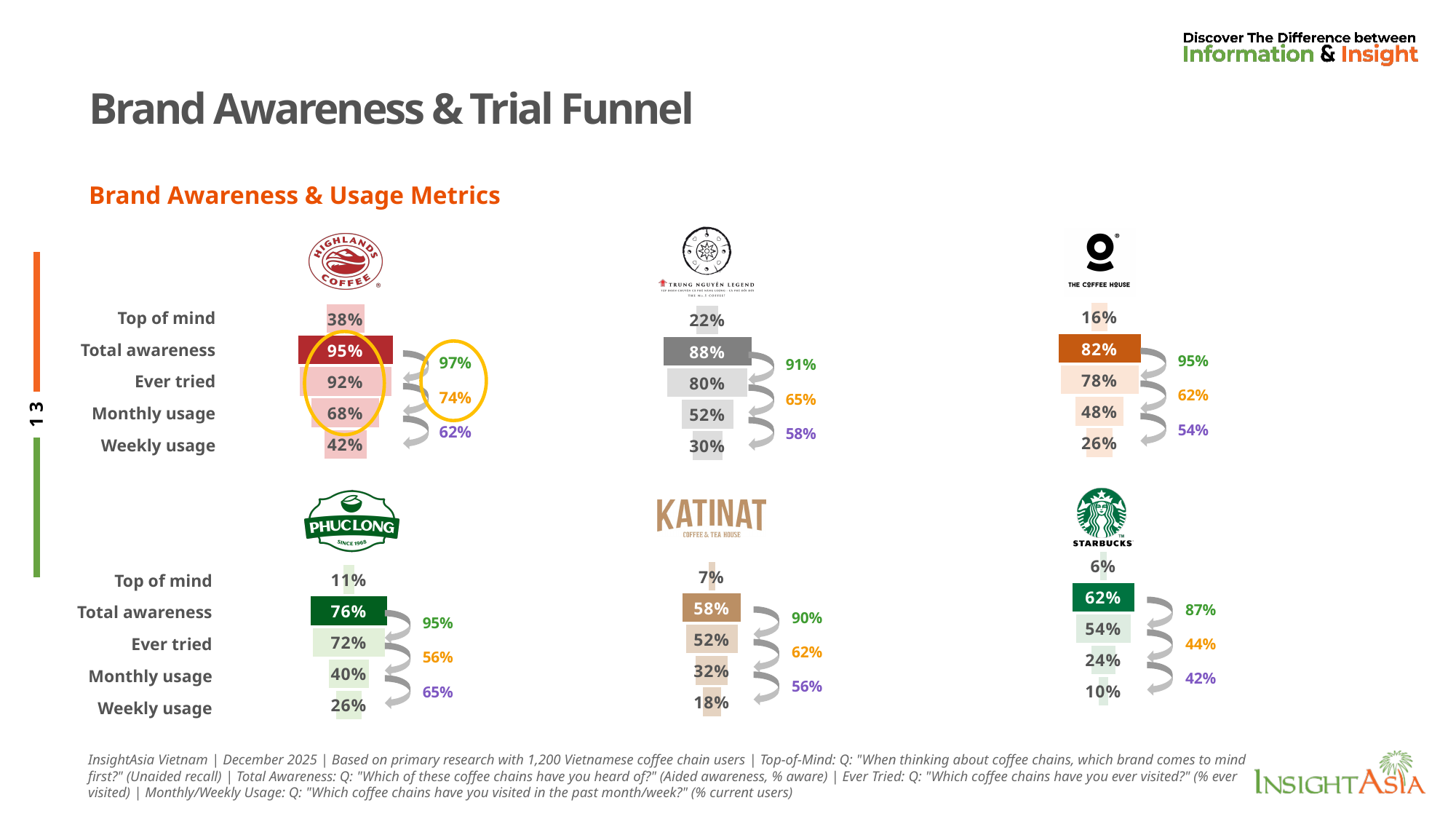
In the Trung Nguyen Legend funnel, what is the Monthly usage value? 52% In The Coffee House funnel, what is the difference between Monthly usage and Weekly usage? 22% In each brand funnel, do the values rise or fall from Total awareness down to Weekly usage? fall In the Starbucks funnel, what is the Top of mind value? 6% Which is larger: Ever tried for Trung Nguyen Legend or Ever tried for The Coffee House? Trung Nguyen Legend How many metrics are listed in each brand funnel (from Top of mind to Weekly usage)? 5 In the Katinat funnel, what is the Weekly usage value? 18% How many brand funnels are shown on the slide? 6 Across the six brand funnels, which brand has the lowest Total awareness value? Katinat Across the six brand funnels, which brand has the highest Top of mind value? Highlands Coffee In the Phuc Long funnel, what is the difference between Total awareness and Ever tried? 4% In the Highlands Coffee funnel, what is the Total awareness value? 95%